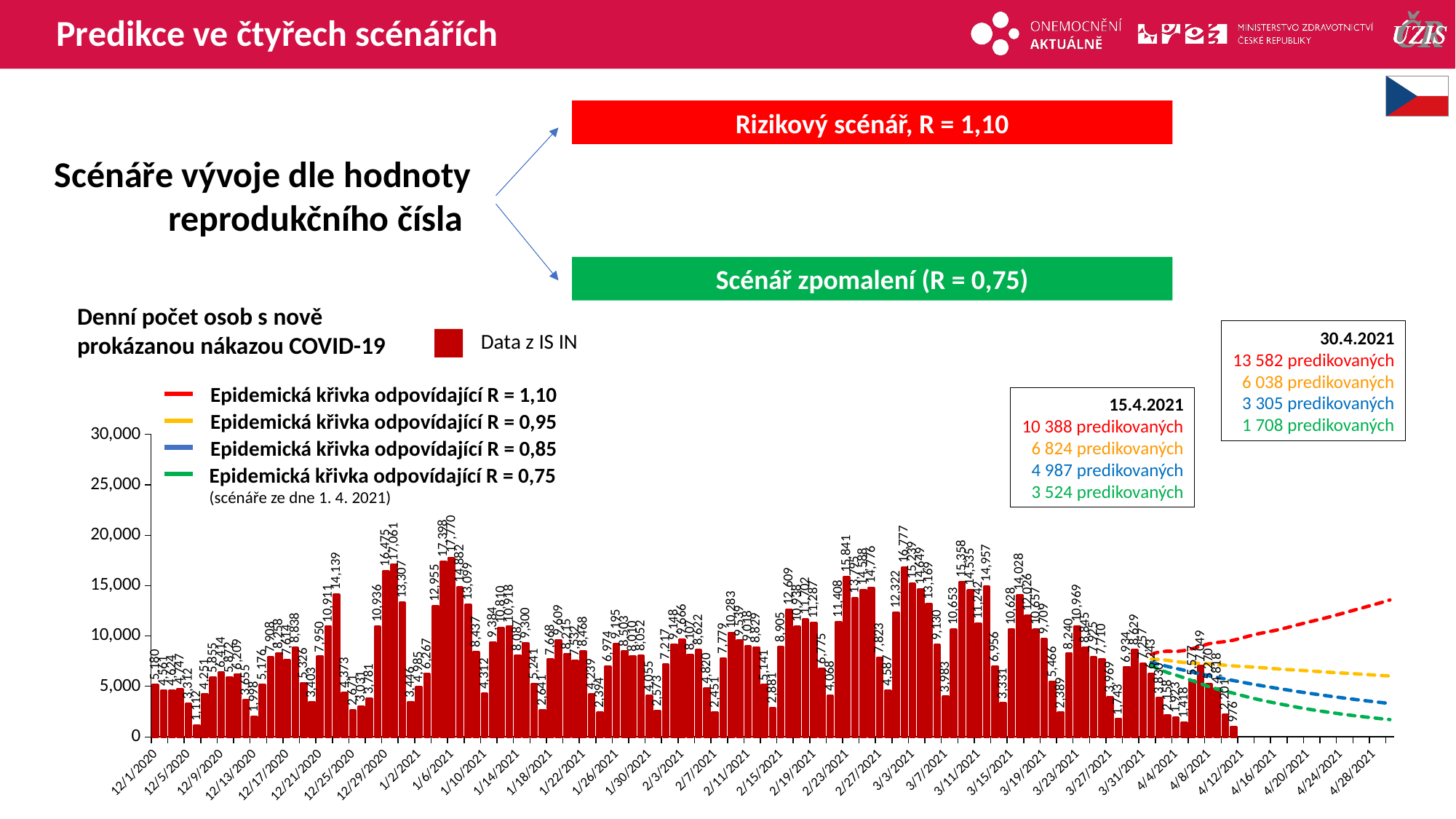
Under the R = 0,95 scenario, is the prediction for 15.4.2021 or for 30.4.2021 larger? 15.4.2021 How many cases are predicted for 30.4.2021 under the R = 0,85 scenario? 3 305 According to the annotation box, how many cases are predicted for 30.4.2021 under the R = 1,10 scenario? 13 582 How many epidemic curves (Epidemická křivka) does the legend list? 4 Does the red dashed curve (R = 1,10) rise or fall from early April to the end of April 2021? rise What is the difference between the R = 1,10 and R = 0,75 predictions for 30.4.2021? 11 874 According to the annotation box, how many cases are predicted for 15.4.2021 under the R = 0,75 scenario? 3 524 What kind of chart is used to show the daily number of newly confirmed COVID-19 cases? bar chart What is the difference between the R = 1,10 and R = 0,75 predictions for 15.4.2021? 6 864 Which scenario gives the lowest predicted number of cases for 30.4.2021? R = 0,75 What colour is the epidemic curve corresponding to R = 0,75 in the legend? green Is the value of the bar for 12/1/2020 greater or less than 10,000? less